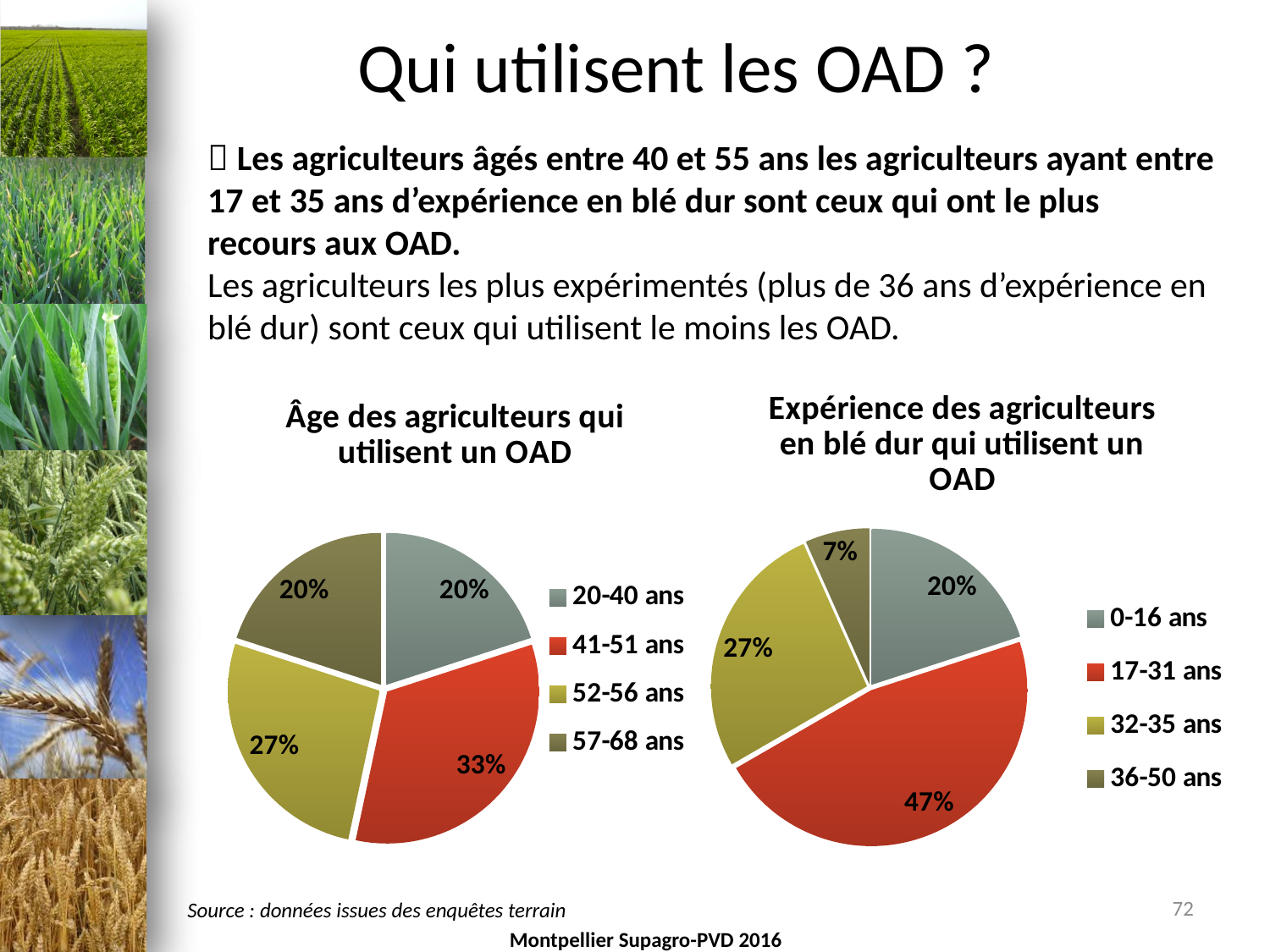
In the chart titled "Expérience des agriculteurs en blé dur qui utilisent un OAD", what is the difference between the shares for 17-31 ans and 36-50 ans? 40% In the chart titled "Expérience des agriculteurs en blé dur qui utilisent un OAD", which experience group has the smallest slice? 36-50 ans In the chart titled "Âge des agriculteurs qui utilisent un OAD", what is the difference between the shares for 41-51 ans and 52-56 ans? 6% In the chart titled "Expérience des agriculteurs en blé dur qui utilisent un OAD", what share is shown for 36-50 ans? 7% In the chart titled "Âge des agriculteurs qui utilisent un OAD", what share is shown for 41-51 ans? 33% In the chart titled "Âge des agriculteurs qui utilisent un OAD", what share is shown for 52-56 ans? 27% In the chart titled "Expérience des agriculteurs en blé dur qui utilisent un OAD", which experience group has the largest slice? 17-31 ans In the chart titled "Expérience des agriculteurs en blé dur qui utilisent un OAD", which is larger: the share for 0-16 ans or the share for 32-35 ans? 32-35 ans What type of chart is the chart on the right of the slide? Pie chart In the chart titled "Expérience des agriculteurs en blé dur qui utilisent un OAD", what share is shown for 17-31 ans? 47% In the chart titled "Âge des agriculteurs qui utilisent un OAD", how many slices does the pie have? 4 In the chart titled "Âge des agriculteurs qui utilisent un OAD", which age group has the largest slice? 41-51 ans